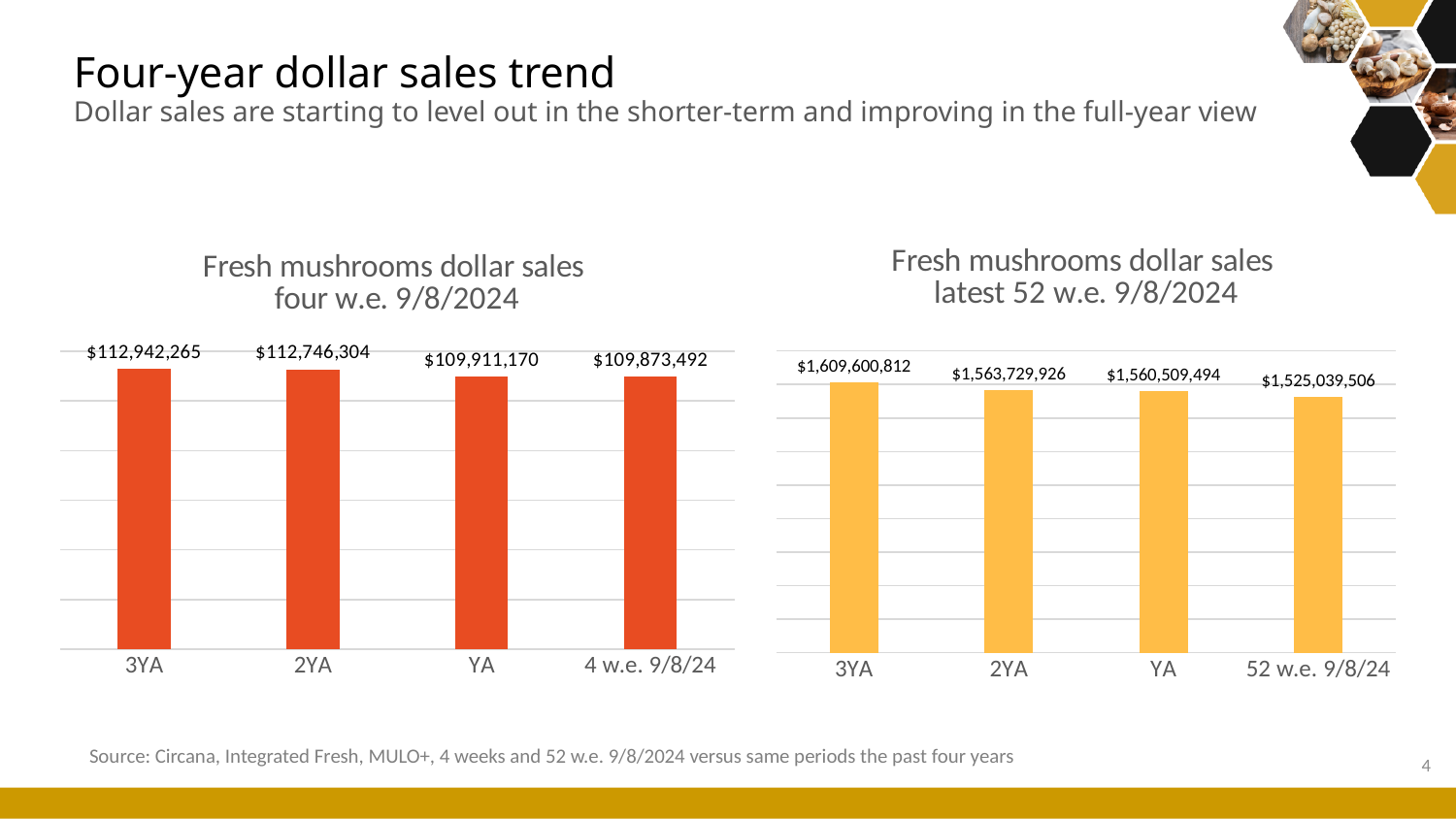
In the 'Fresh mushrooms dollar sales four w.e. 9/8/2024' chart, what is the value for 3YA? $112,942,265 In the 'Fresh mushrooms dollar sales four w.e. 9/8/2024' chart, what is the value for 4 w.e. 9/8/24? $109,873,492 In the 'Fresh mushrooms dollar sales latest 52 w.e. 9/8/2024' chart, what is the value for 52 w.e. 9/8/24? $1,525,039,506 In the 'Fresh mushrooms dollar sales latest 52 w.e. 9/8/2024' chart, what is the difference between the 3YA value and the 52 w.e. 9/8/24 value? $84,561,306 How many bars are in the 'Fresh mushrooms dollar sales four w.e. 9/8/2024' chart? 4 In the 'Fresh mushrooms dollar sales four w.e. 9/8/2024' chart, what is the difference between the 3YA value and the 4 w.e. 9/8/24 value? $3,068,773 In the 'Fresh mushrooms dollar sales four w.e. 9/8/2024' chart, which period has the highest value? 3YA In the 'Fresh mushrooms dollar sales latest 52 w.e. 9/8/2024' chart, do the values rise or fall from 3YA to 52 w.e. 9/8/24? Fall What type of chart is the 'Fresh mushrooms dollar sales latest 52 w.e. 9/8/2024' chart? Bar chart In the 'Fresh mushrooms dollar sales latest 52 w.e. 9/8/2024' chart, which is larger, the value for 3YA or the value for YA? 3YA In the 'Fresh mushrooms dollar sales latest 52 w.e. 9/8/2024' chart, what is the value for 2YA? $1,563,729,926 In the 'Fresh mushrooms dollar sales latest 52 w.e. 9/8/2024' chart, which period has the lowest value? 52 w.e. 9/8/24